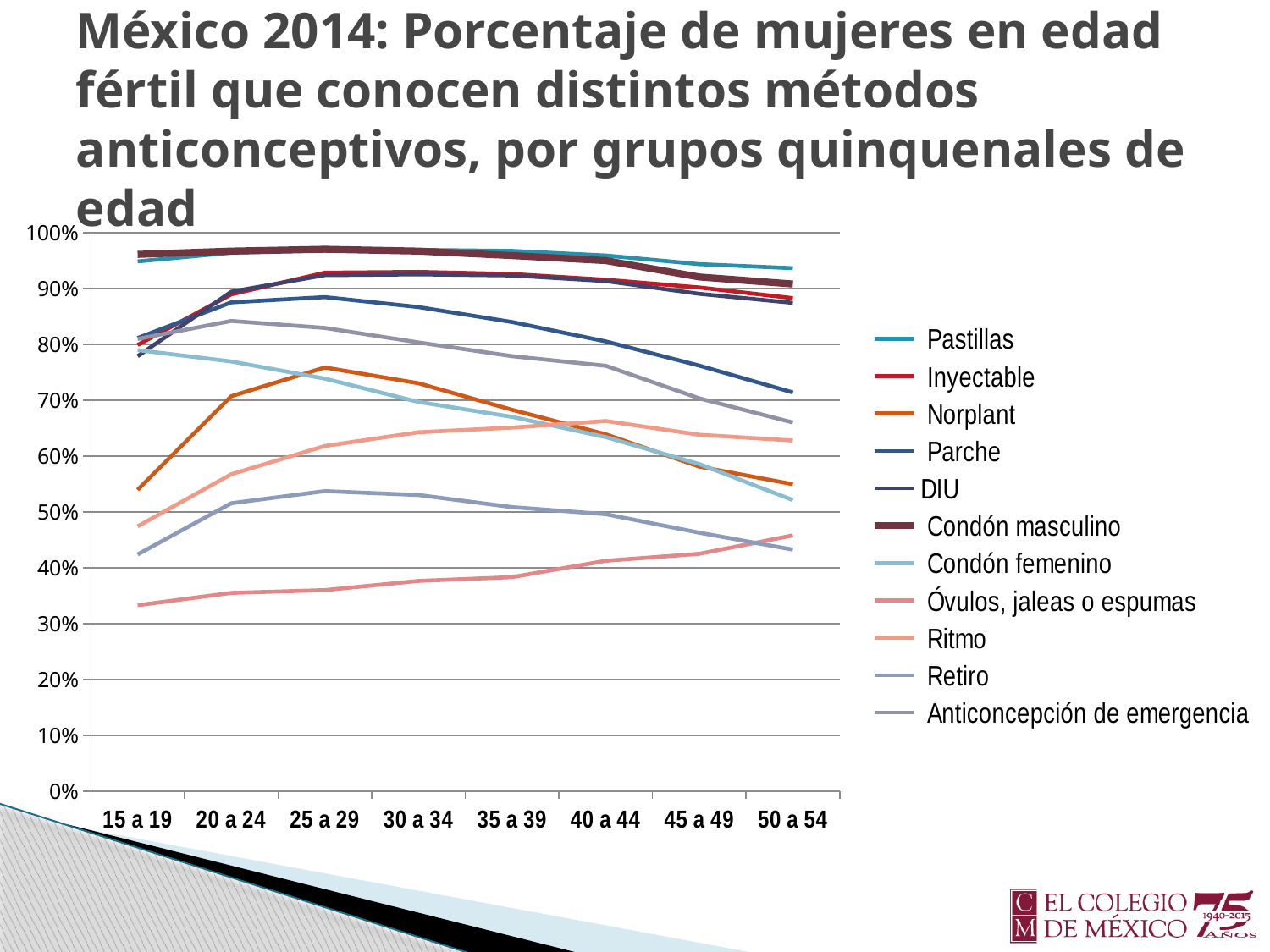
Which method has the lowest value in the 15 a 19 age group? Óvulos, jaleas o espumas Is the value for Óvulos, jaleas o espumas in the 15 a 19 group greater or less than 40%? less What kind of chart is shown on the slide? line chart Is the value for Condón femenino in the 50 a 54 group greater or less than 60%? less In the 50 a 54 group, which is higher: Parche or Anticoncepción de emergencia? Parche Does the line for Condón femenino rise or fall from the 15 a 19 group to the 50 a 54 group? fall Which series is listed first in the legend? Pastillas Is the value for Retiro in the 50 a 54 group greater or less than 50%? less How many series does the legend list? 11 Does the line for Óvulos, jaleas o espumas rise or fall from the 15 a 19 group to the 50 a 54 group? rise How many age groups are shown on the x axis? 8